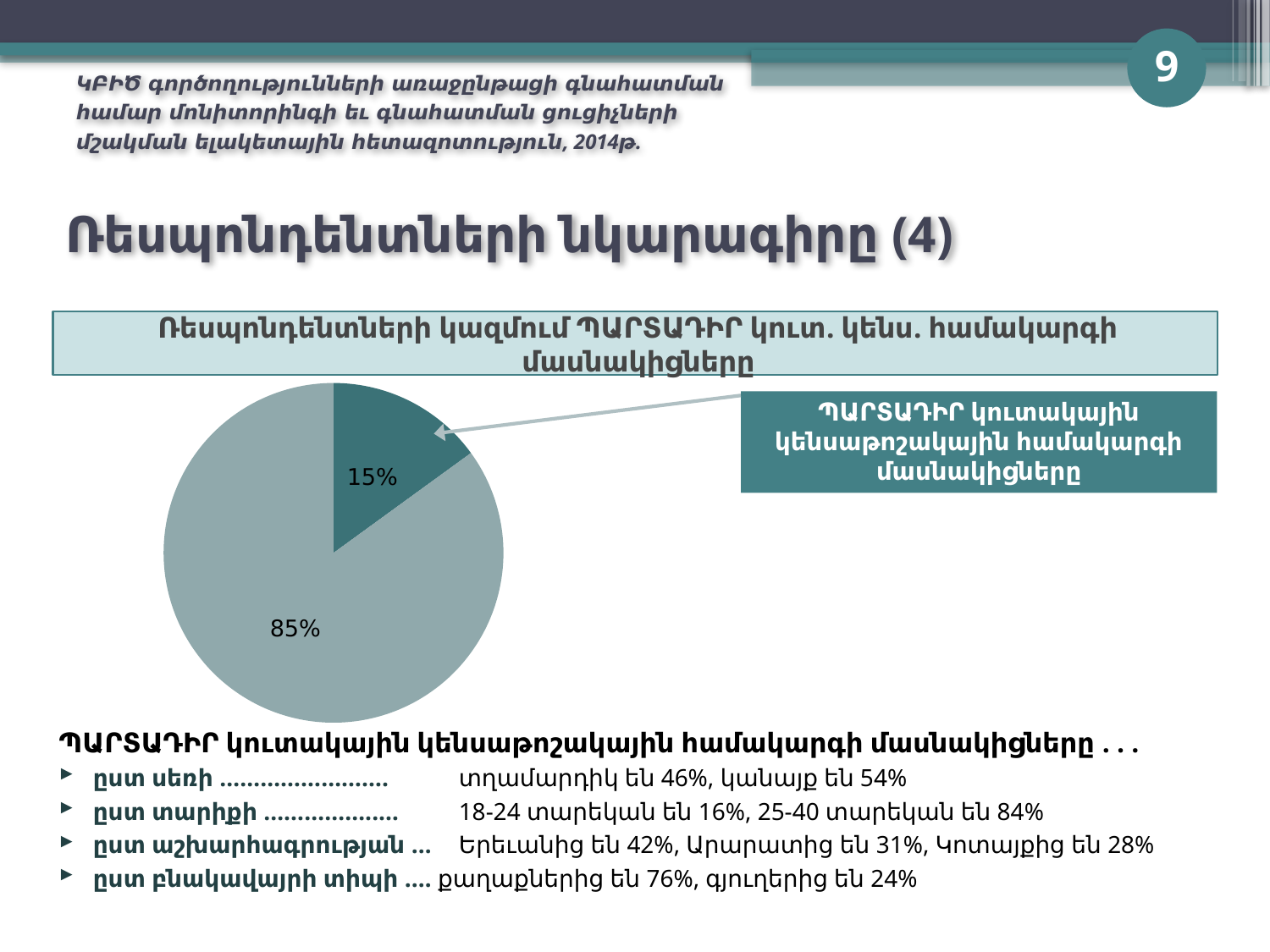
What value is shown on the smaller slice of the pie chart? 15% Is the slice for participants of the mandatory funded pension system larger or smaller than the other slice? smaller What is the title of the pie chart? Ռեսպոնդենտների կազմում ՊԱՐՏԱԴԻՐ կուտ. կենս. համակարգի մասնակիցները Which slice of the pie chart is drawn in the darker teal colour, the 15% slice or the 85% slice? 15% Is the share of participants of the mandatory funded pension system greater or less than 50%? less What share of the pie is labelled as participants of the mandatory funded pension system (ՊԱՐՏԱԴԻՐ կուտակային կենսաթոշակային համակարգի մասնակիցները)? 15% Which slice is the largest in the pie chart, the one labelled 15% or the one labelled 85%? 85% What is the smallest value shown in the pie chart? 15% What is the difference between the two slices of the pie chart? 70 percentage points What value is shown on the larger slice of the pie chart? 85% What kind of chart is shown on the slide? pie chart How many slices does the pie chart have? 2